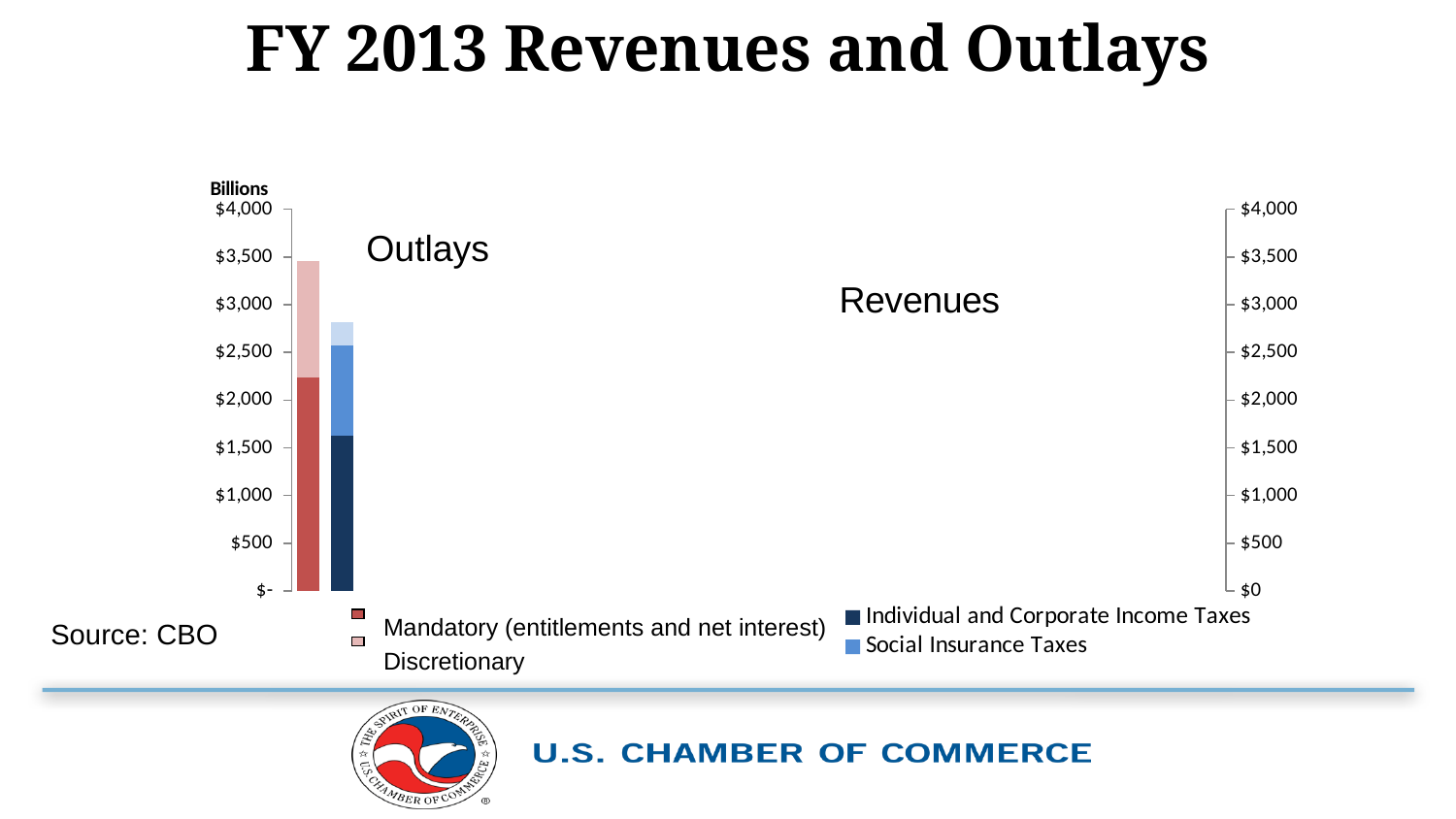
How many series does the legend list? 4 What unit is indicated at the top of the left axis? Billions What source is cited for the chart data? CBO What kind of chart is shown on the slide? Stacked bar chart Is the total of the Revenues bar greater or less than $3,000? less Within the Outlays bar, which segment is larger, Mandatory (entitlements and net interest) or Discretionary? Mandatory (entitlements and net interest) Which bar is taller, Outlays or Revenues? Outlays Within the Revenues bar, which segment is larger, Individual and Corporate Income Taxes or Social Insurance Taxes? Individual and Corporate Income Taxes Is the total of the Outlays bar greater or less than $3,000? greater How many bars are plotted in the chart? 2 Is the Mandatory (entitlements and net interest) segment of the Outlays bar greater or less than $2,000? greater